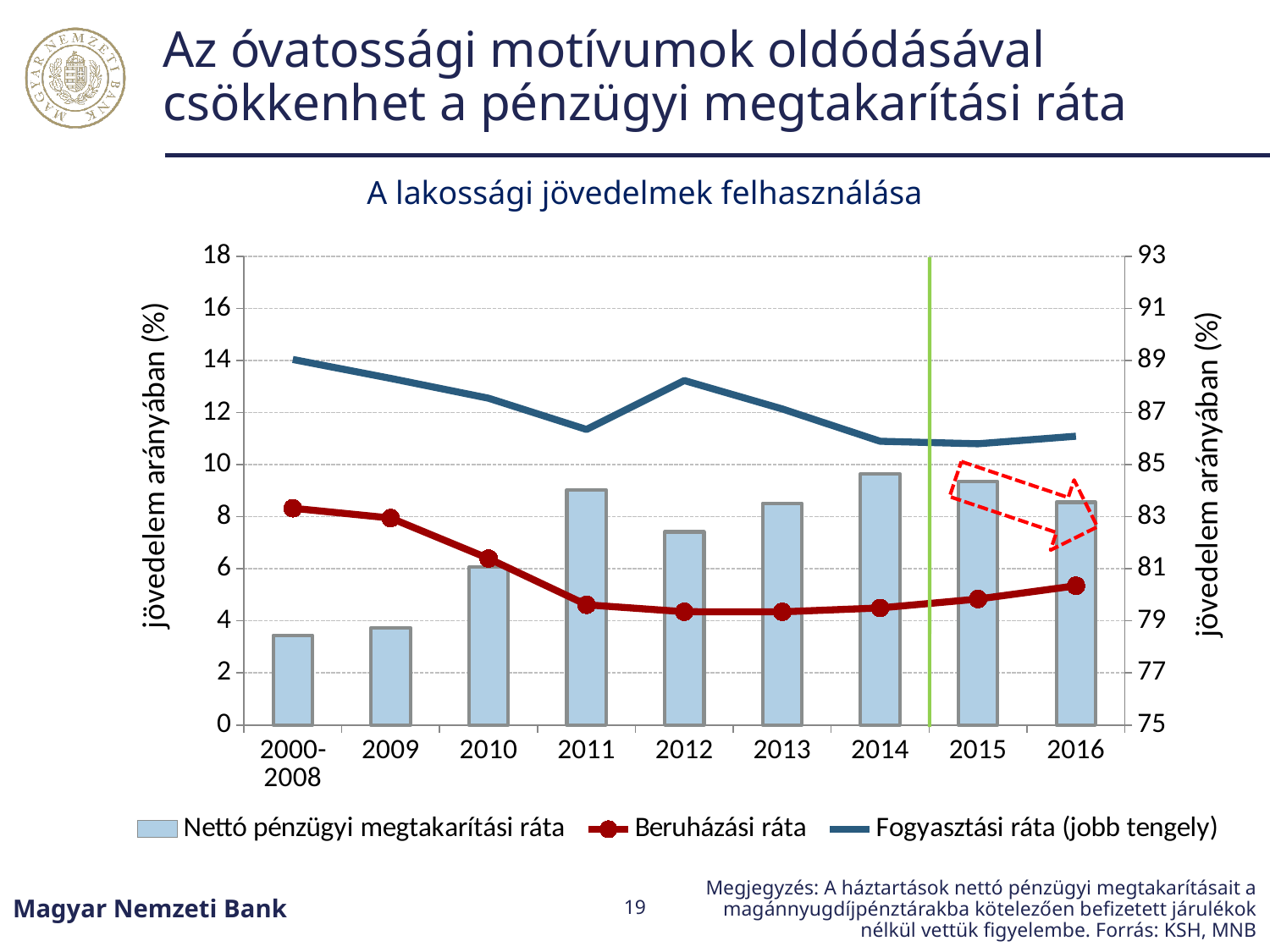
In which category is the Fogyasztási ráta highest? 2000-2008 In which category is the Beruházási ráta highest? 2000-2008 How many series does the legend list? 3 Is the Nettó pénzügyi megtakarítási ráta bar for 2011 greater or less than 8? greater What is the title of the chart? A lakossági jövedelmek felhasználása What kind of chart is shown on the slide? A combined bar and line chart How many categories are shown on the x axis? 9 Does the Beruházási ráta rise or fall from 2000-2008 to 2012? fall Is the Fogyasztási ráta value for 2011 greater or less than 87 on the right axis? less Which is larger, the Nettó pénzügyi megtakarítási ráta bar for 2011 or for 2012? 2011 Is the Nettó pénzügyi megtakarítási ráta bar for 2009 greater or less than 4? less Which series is plotted on the right axis according to the legend? Fogyasztási ráta (jobb tengely)